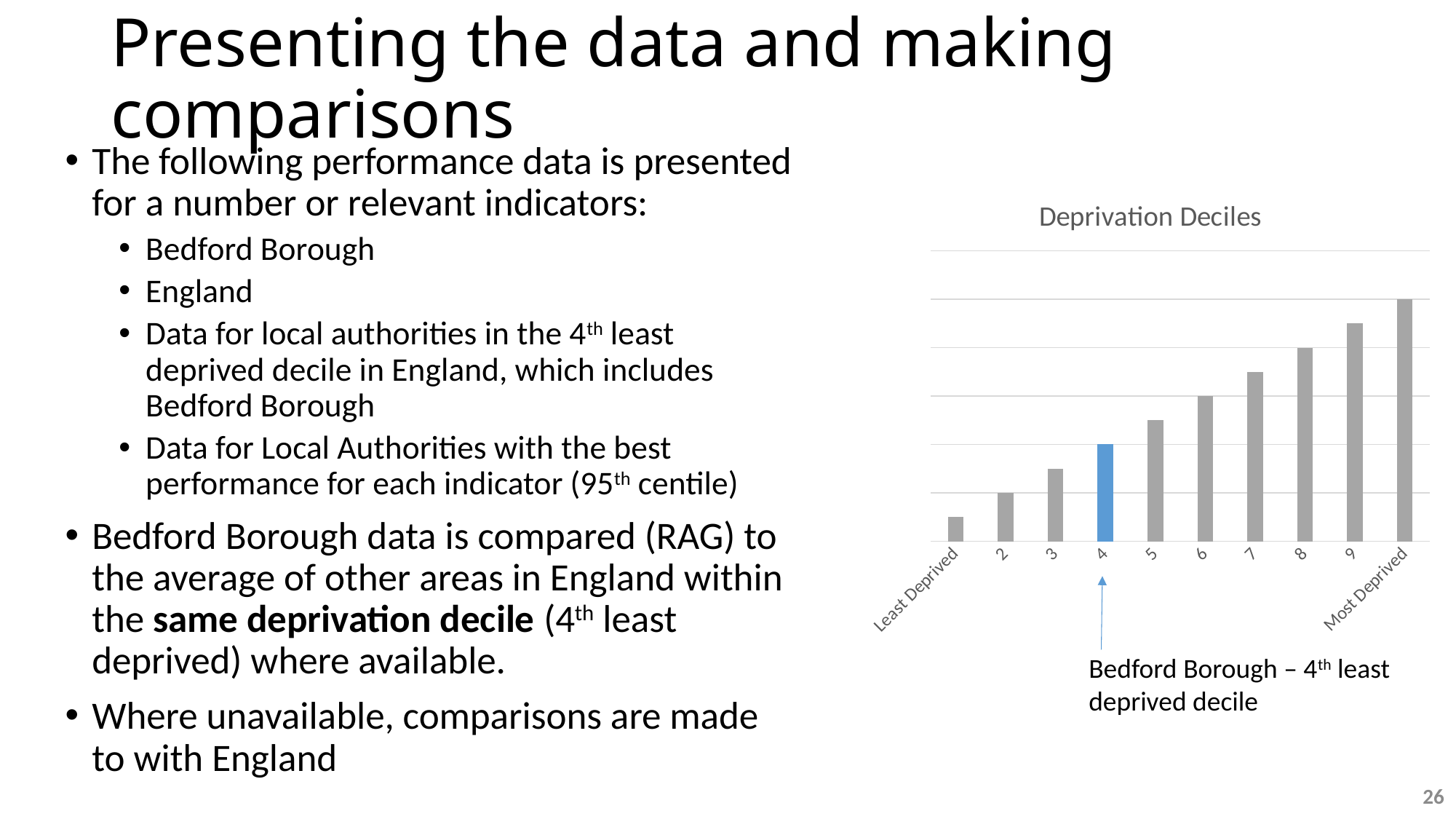
Which bar is taller, decile 7 or decile 3? 7 What is the label of the last category on the x axis? Most Deprived Which bar in the chart is coloured blue rather than grey? 4 Which category has the shortest bar in the Deprivation Deciles chart? Least Deprived What is the title of the chart? Deprivation Deciles What kind of chart is shown on the slide? Bar chart Which bar is taller, decile 2 or decile 9? 9 Do the bars rise or fall moving from Least Deprived to Most Deprived along the x axis? Rise How many bars are plotted in the Deprivation Deciles chart? 10 What is the label of the first category on the x axis? Least Deprived Which bar is shorter, decile 5 or decile 8? 5 Which category has the tallest bar in the Deprivation Deciles chart? Most Deprived